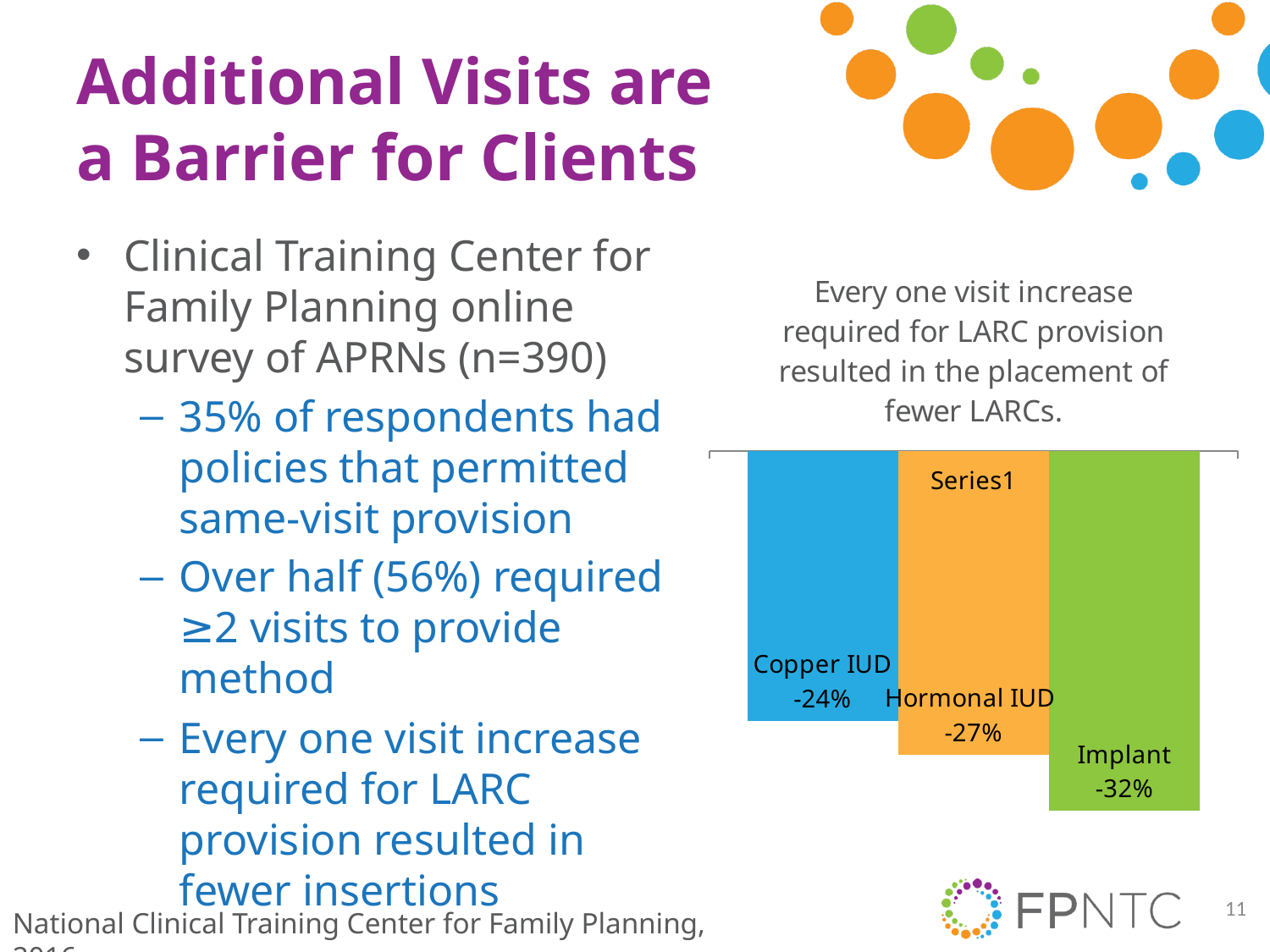
Which has a larger decrease, Hormonal IUD or Implant? Implant Which category shows the largest decrease in the chart? Implant What is the value for Copper IUD in the chart? -24% What is the value for Implant in the chart? -32% What is the difference in percentage points between the Hormonal IUD value and the Copper IUD value? 3 percentage points What is the value for Hormonal IUD in the chart? -27% Do the values decrease or increase moving from Copper IUD to Implant along the x axis? Decrease What is the difference in percentage points between the Implant value and the Copper IUD value? 8 percentage points How many categories are plotted in the chart? 3 What kind of chart is shown on the slide? Bar chart Which category shows the smallest decrease in the chart? Copper IUD What series name is shown on the chart? Series1